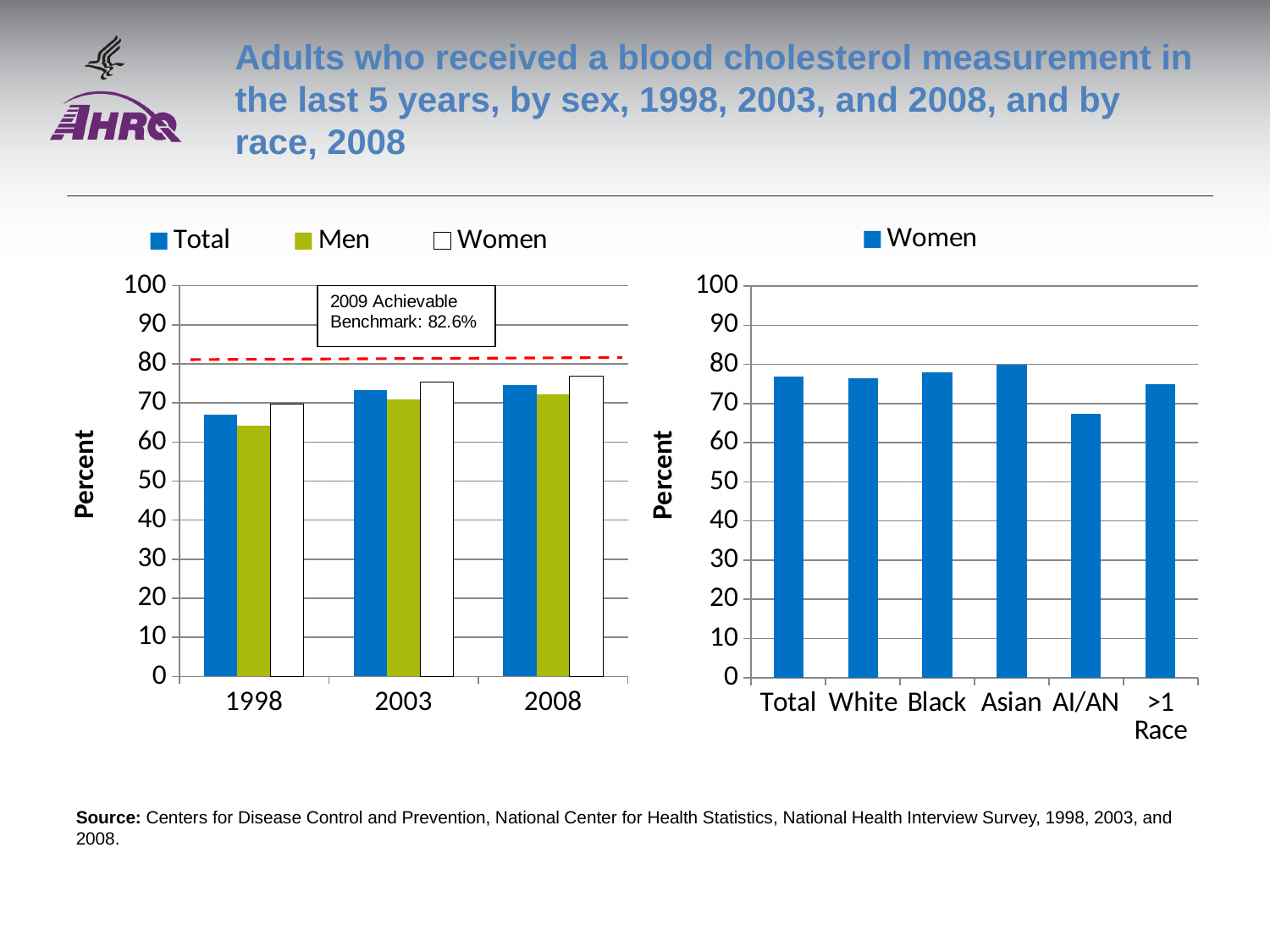
On the right chart, is the value for AI/AN greater or less than 70? less What kind of chart is the left chart on the slide? bar chart What is the 2009 Achievable Benchmark shown on the left chart? 82.6% On the left chart, is the value for Women in 2008 greater or less than 70? greater How many series does the legend of the left chart list? 3 On the left chart, is the value for Men in 1998 greater or less than 70? less On the right chart, which is larger: the value for Asian or the value for AI/AN? Asian On the right chart, which race category has the lowest value? AI/AN What is the label of the y axis on the right chart? Percent How many race categories are shown on the right chart? 6 On the left chart, does the Total value rise or fall from 1998 to 2008? rise On the left chart, which is larger in 1998: the value for Men or the value for Women? Women